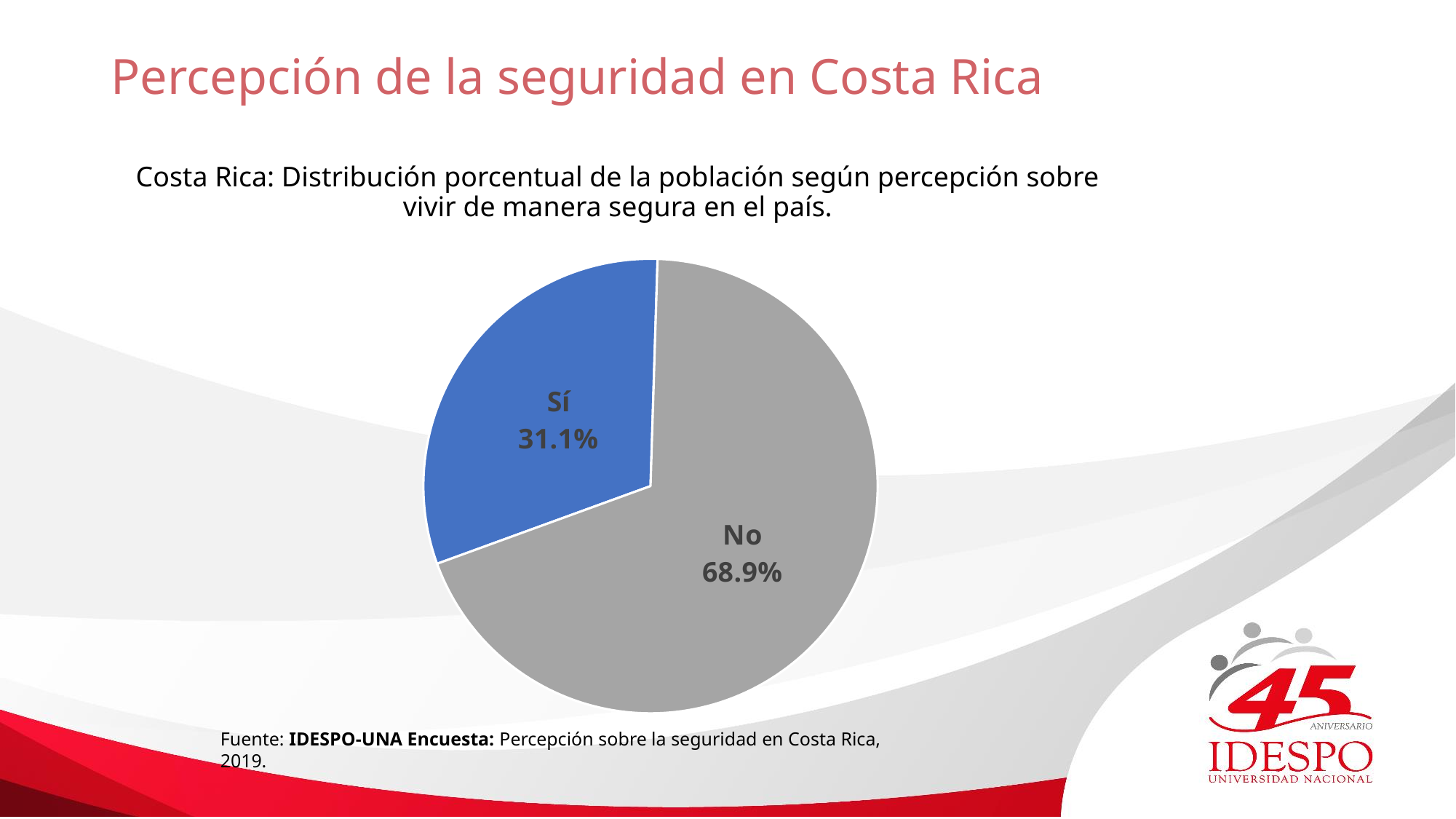
What is the difference in percentage points between the "No" and "Sí" slices? 37.8 What percentage of the population answered "No"? 68.9% What is the title of the chart? Costa Rica: Distribución porcentual de la población según percepción sobre vivir de manera segura en el país. Which is larger, the share for "Sí" or the share for "No"? No What type of chart is shown on the slide? pie chart How many slices does the pie chart have? 2 What percentage of the population answered "Sí"? 31.1% Which slice of the pie is the smallest? Sí Which slice of the pie is the largest? No What share of the pie does the "Sí" slice represent? 31.1% What colour is the "Sí" slice? blue